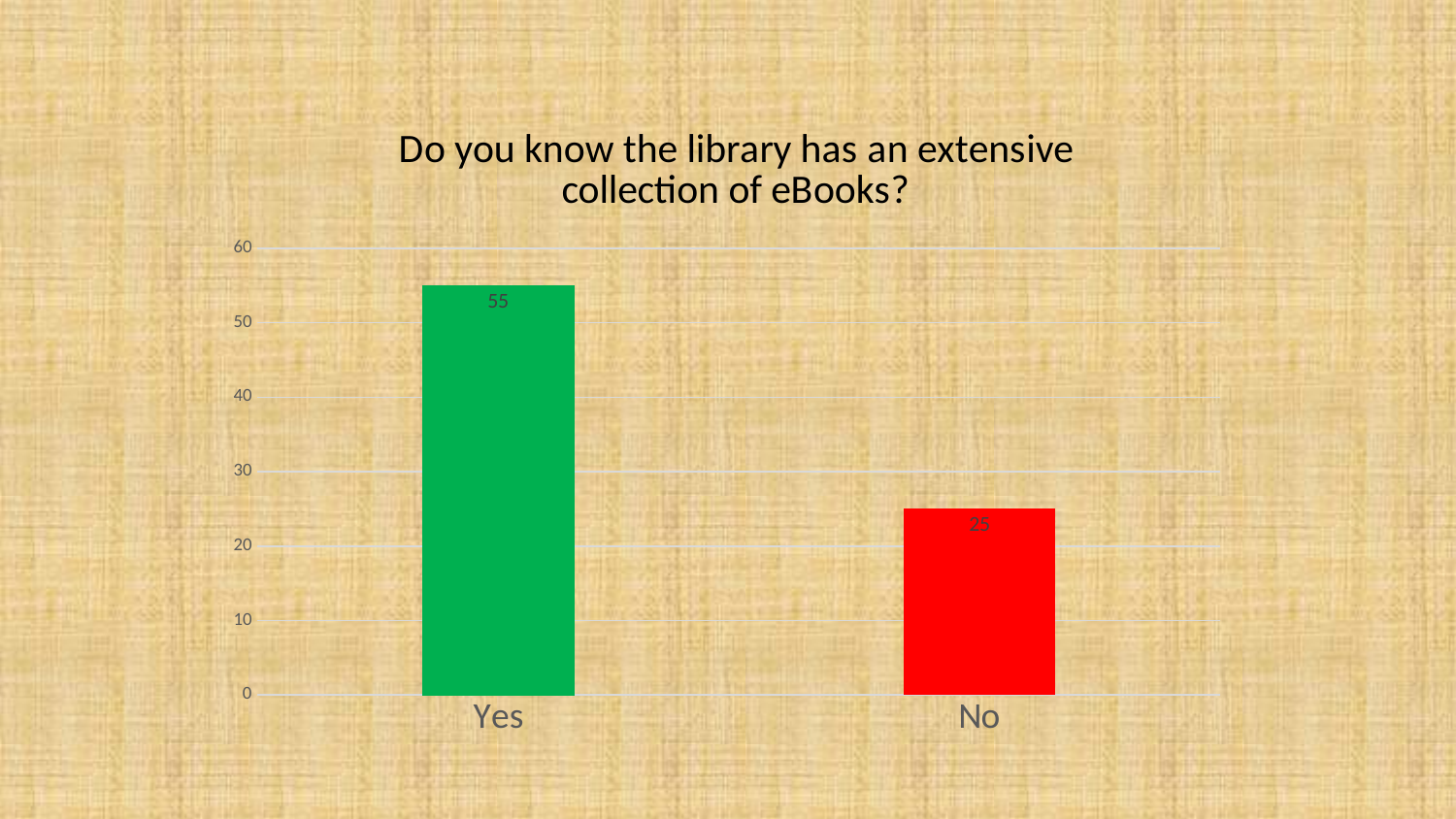
What colour is the bar for No? red Which is larger, the value for Yes or the value for No? Yes What is the value for Yes? 55 What is the value for No? 25 Is the value for No greater or less than 30? less What is the title of the chart? Do you know the library has an extensive collection of eBooks? What kind of chart is shown on the slide? bar chart What is the difference between the values for Yes and No? 30 Which category has the lowest value? No Is the value for Yes greater or less than 50? greater How many categories are shown on the chart? 2 Which category has the highest value? Yes